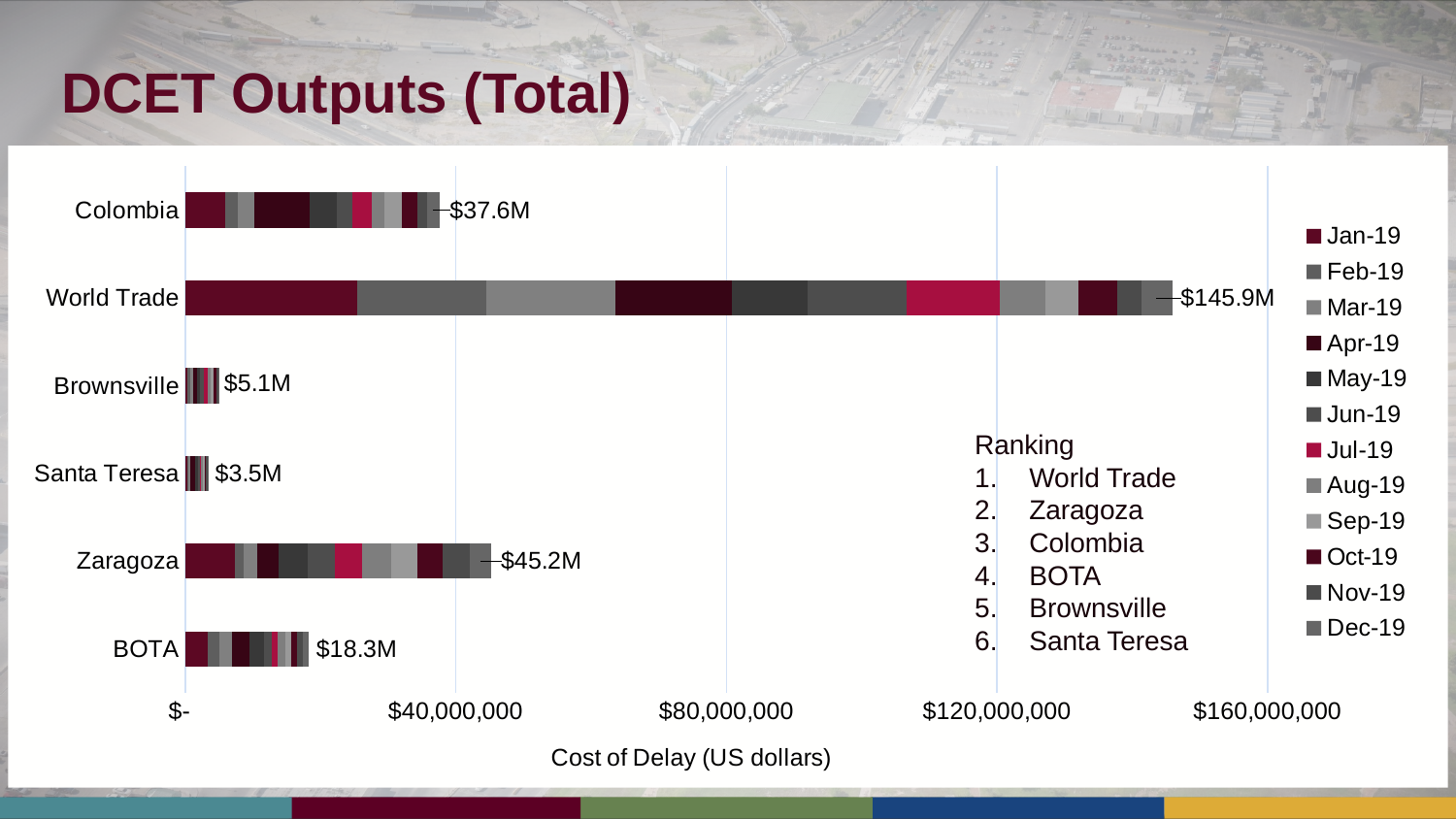
What is the difference between the total cost of delay for World Trade and Zaragoza? $100.7M Which port of entry has the highest total cost of delay? World Trade How many ports of entry are shown on the chart? 6 Which has a larger total cost of delay, Brownsville or BOTA? BOTA What is the difference between the total cost of delay for Zaragoza and Colombia? $7.6M What is the total cost of delay shown for BOTA? $18.3M Is the total cost of delay for World Trade greater or less than $120,000,000? greater What is the total cost of delay shown for Zaragoza? $45.2M What is the total cost of delay shown for Santa Teresa? $3.5M What is the total cost of delay shown for World Trade? $145.9M Which port of entry has the lowest total cost of delay? Santa Teresa How many series does the legend list? 12